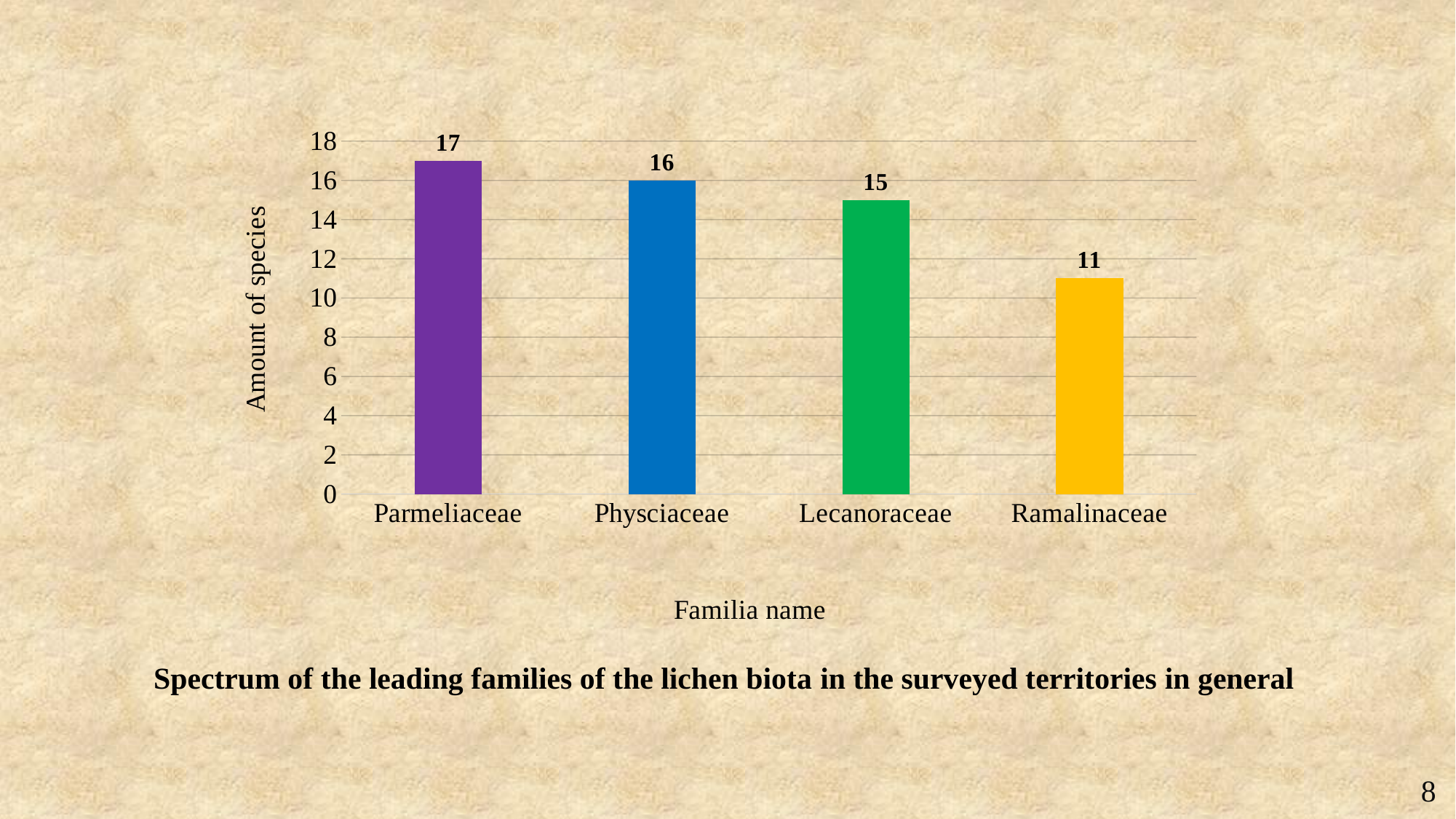
What is the amount of species for Lecanoraceae? 15 Which family has the highest amount of species? Parmeliaceae Which has more species, Physciaceae or Lecanoraceae? Physciaceae Which family has the lowest amount of species? Ramalinaceae What is the value for Ramalinaceae? 11 What is the difference between the values for Parmeliaceae and Ramalinaceae? 6 What is the value for Physciaceae? 16 What is the label of the vertical axis? Amount of species How many species are shown for Parmeliaceae? 17 How many families are shown on the chart? 4 What kind of chart is shown on the slide? bar chart Is the value for Ramalinaceae greater or less than 12? less